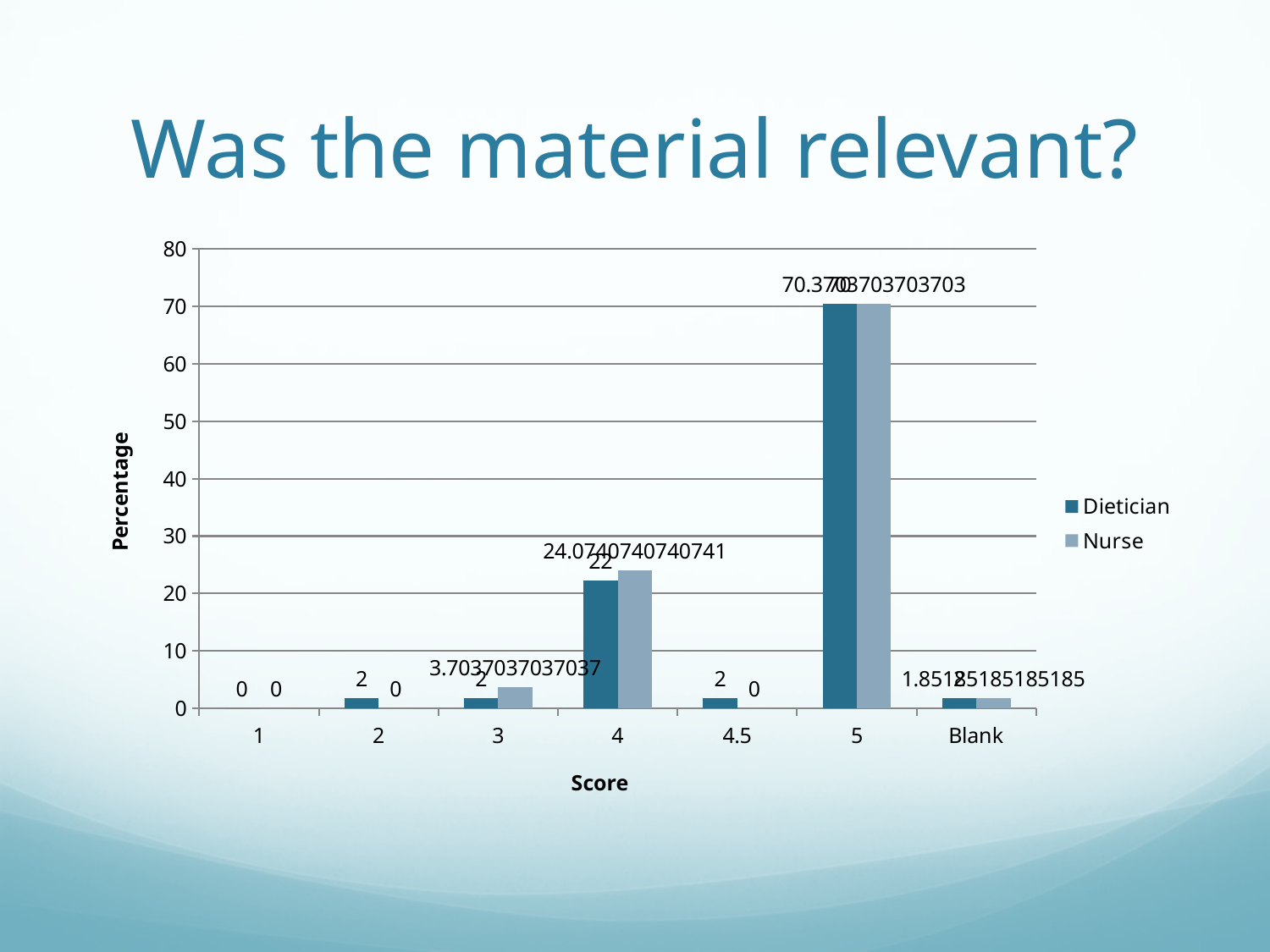
What is the Nurse value for score 4? 24.0740740740741 What is the Dietician value for score 4.5? 2 What is the Nurse value for score 2? 0 What is the difference between the Nurse and Dietician values for score 4? 2.0740740740741 How many series does the legend list? 2 What is the Nurse value for score 3? 3.7037037037037 What is the Dietician value for score 4? 22 Is the Nurse value for score 5 greater or less than 60? greater Which score has the highest Dietician value? 5 For score 4, which series has the larger value, Dietician or Nurse? Nurse How many score categories are shown on the x axis? 7 What kind of chart is shown on the slide? bar chart